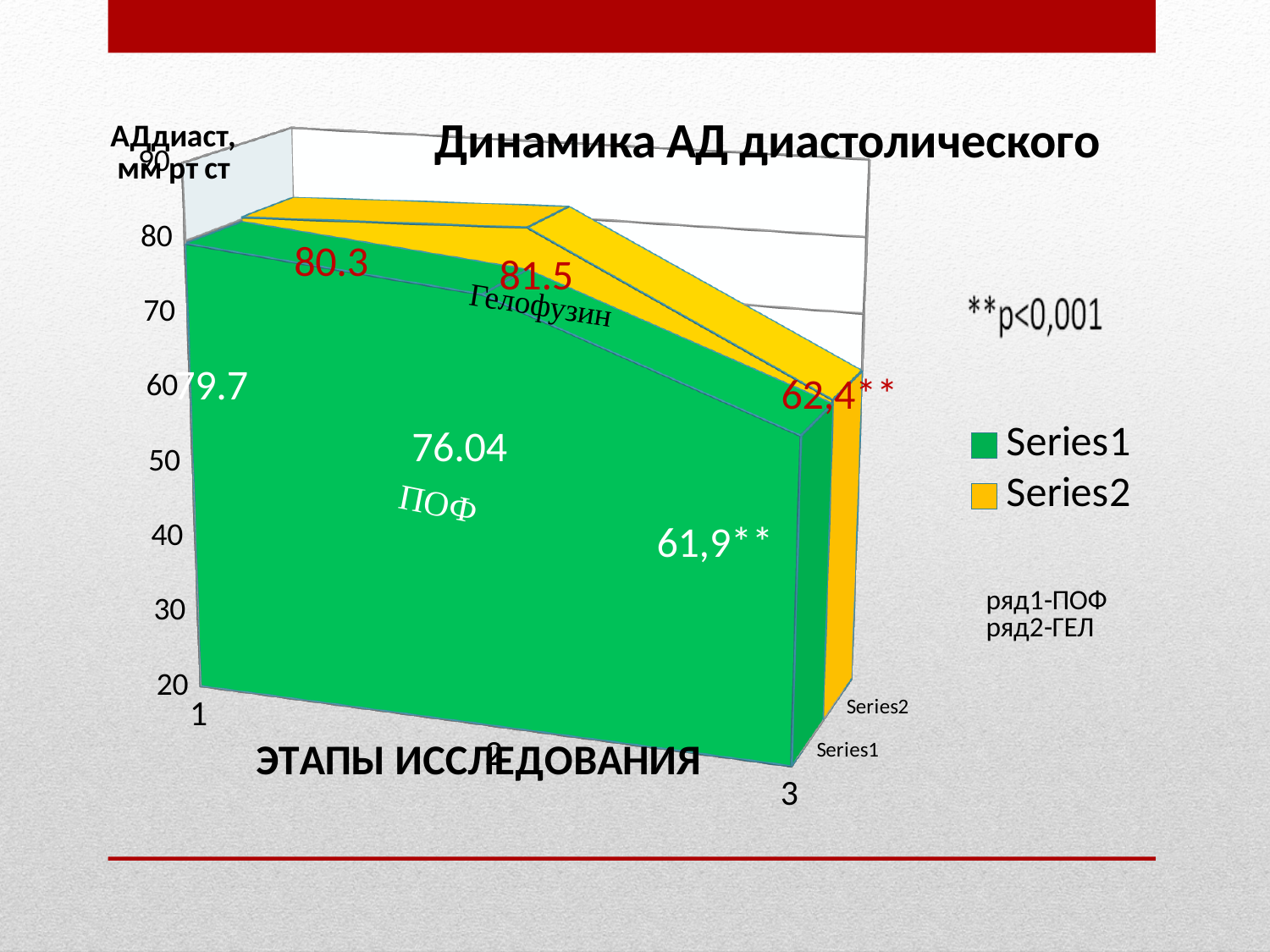
What is the value of Series1 (ПОФ) at stage 1? 79.7 How many stages (categories) are shown on the x axis? 3 What is the value of Series2 (Гелофузин) at stage 1? 80.3 How many series does the legend list? 2 What is the value of Series2 (Гелофузин) at stage 2? 81.5 What kind of chart is shown on the slide? 3D area chart At stage 2, which series has the larger value, Series1 or Series2? Series2 What is the difference between Series2 and Series1 at stage 2? 5.46 What is the title of the chart? Динамика АД диастолического At which stage is the Series1 (ПОФ) value lowest? 3 What is the value of Series1 (ПОФ) at stage 2? 76.04 At which stage is the Series2 (Гелофузин) value highest? 2